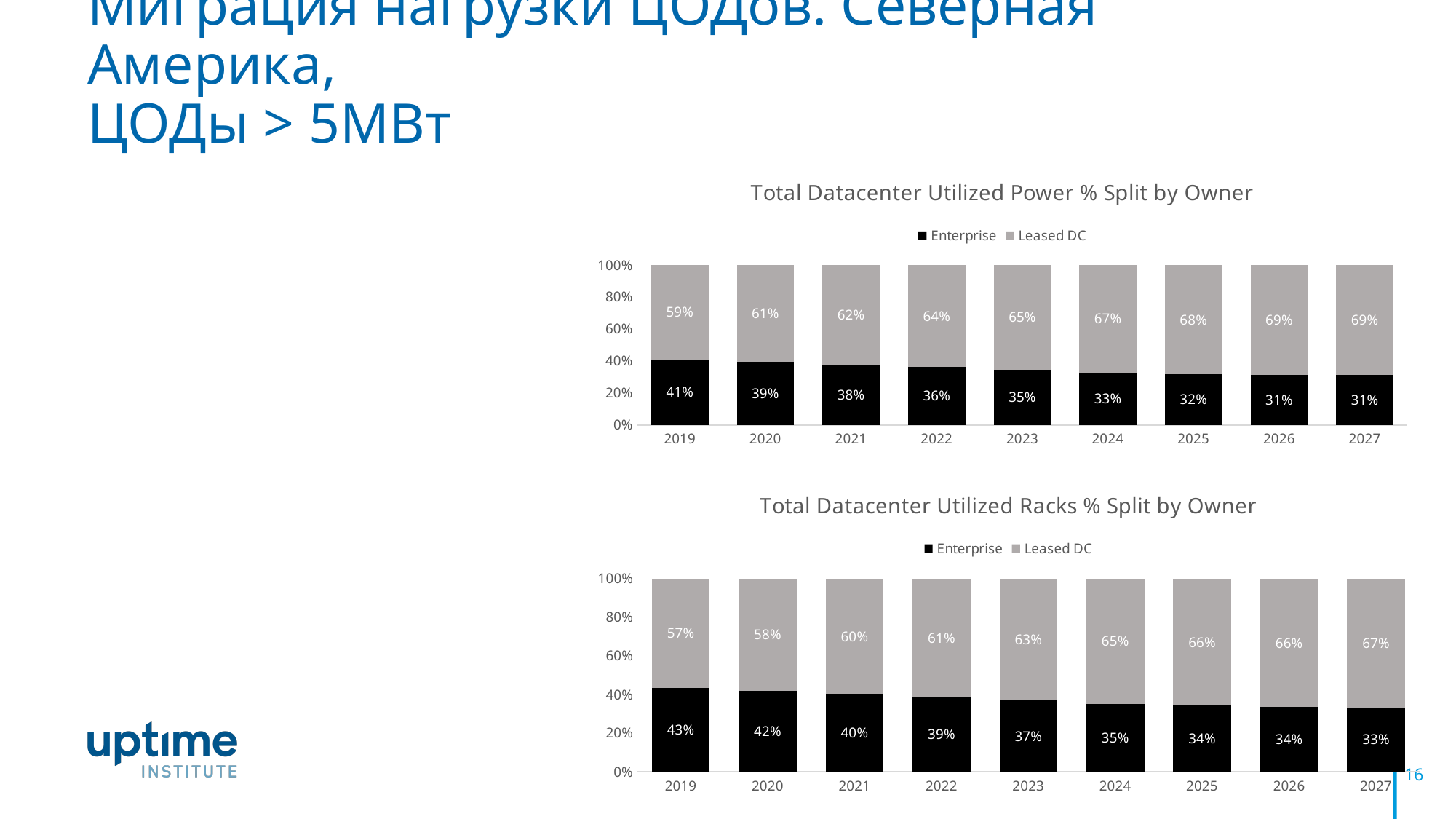
In the 'Total Datacenter Utilized Power % Split by Owner' chart, what is the Leased DC value for 2027? 69% How many years are shown on the x axis of the 'Total Datacenter Utilized Power % Split by Owner' chart? 9 In the 'Total Datacenter Utilized Racks % Split by Owner' chart, what is the Leased DC value for 2021? 60% In the 'Total Datacenter Utilized Racks % Split by Owner' chart, does the Leased DC share rise or fall from 2019 to 2027? Rise What kind of chart is the 'Total Datacenter Utilized Power % Split by Owner' chart? Stacked bar chart In the 'Total Datacenter Utilized Racks % Split by Owner' chart, what is the Enterprise value for 2023? 37% In the 'Total Datacenter Utilized Power % Split by Owner' chart, what is the difference between the Leased DC value in 2027 and in 2019? 10% In the 'Total Datacenter Utilized Power % Split by Owner' chart, which year has the highest Enterprise share? 2019 In the 'Total Datacenter Utilized Racks % Split by Owner' chart, which year has the lowest Enterprise share? 2027 In the 'Total Datacenter Utilized Power % Split by Owner' chart, what is the Enterprise value for 2019? 41% How many series does the legend of the 'Total Datacenter Utilized Racks % Split by Owner' chart list? 2 In the 'Total Datacenter Utilized Racks % Split by Owner' chart, which is larger: the Enterprise value for 2019 or for 2025? 2019